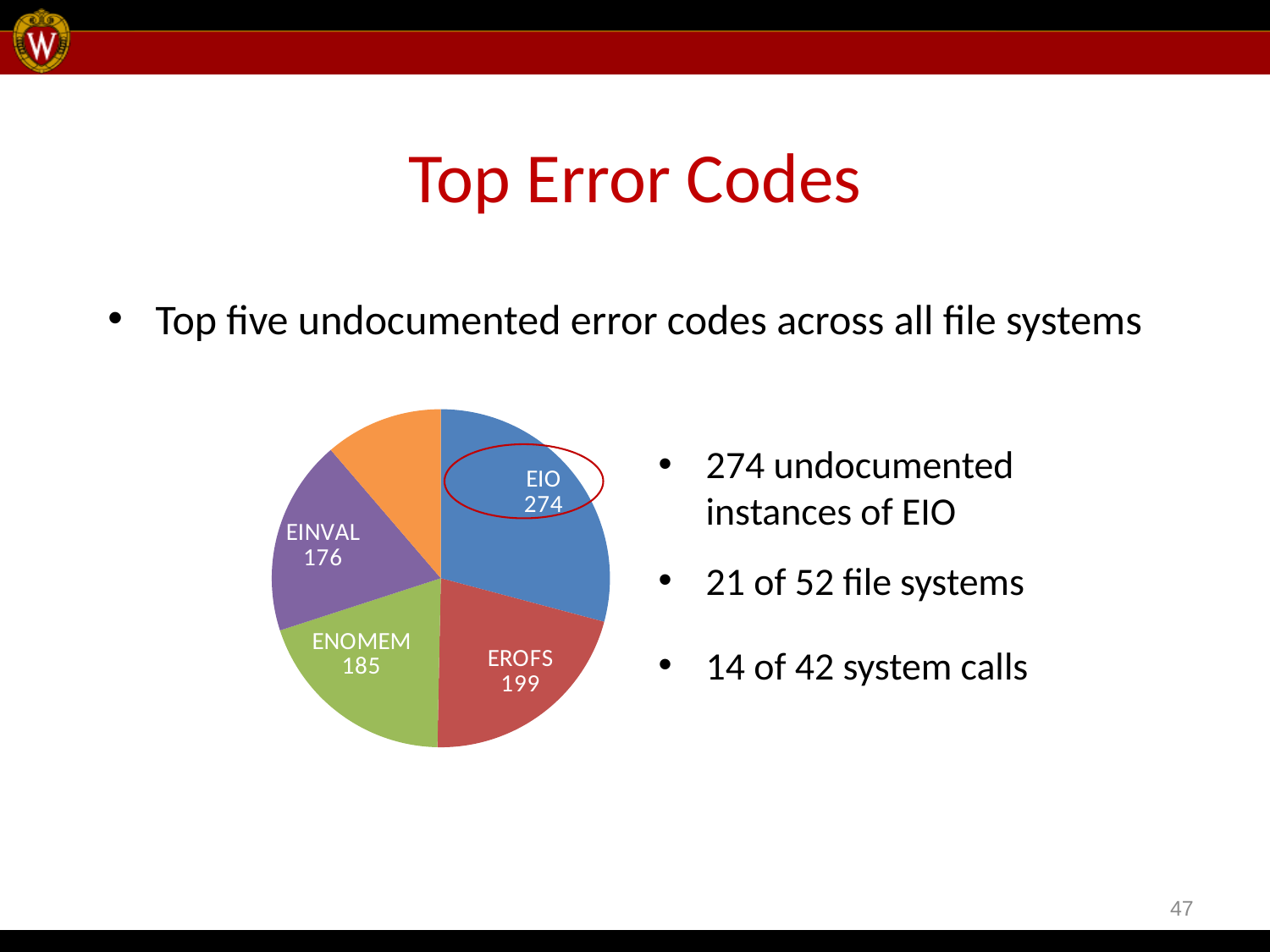
What is the difference between the values for ENOMEM and EINVAL? 9 Among the labeled slices, which error code has the lowest value? EINVAL Which is larger, the value for EROFS or the value for ENOMEM? EROFS Which error code has the largest slice in the pie chart? EIO What is the value shown for ENOMEM in the pie chart? 185 What is the value shown for EIO in the pie chart? 274 How many slices does the pie chart have? 5 What is the value shown for EROFS in the pie chart? 199 What kind of chart is shown on the slide? pie chart What is the value shown for EINVAL in the pie chart? 176 What is the difference between the values for EIO and EROFS? 75 Which slice of the pie chart is circled in red? EIO